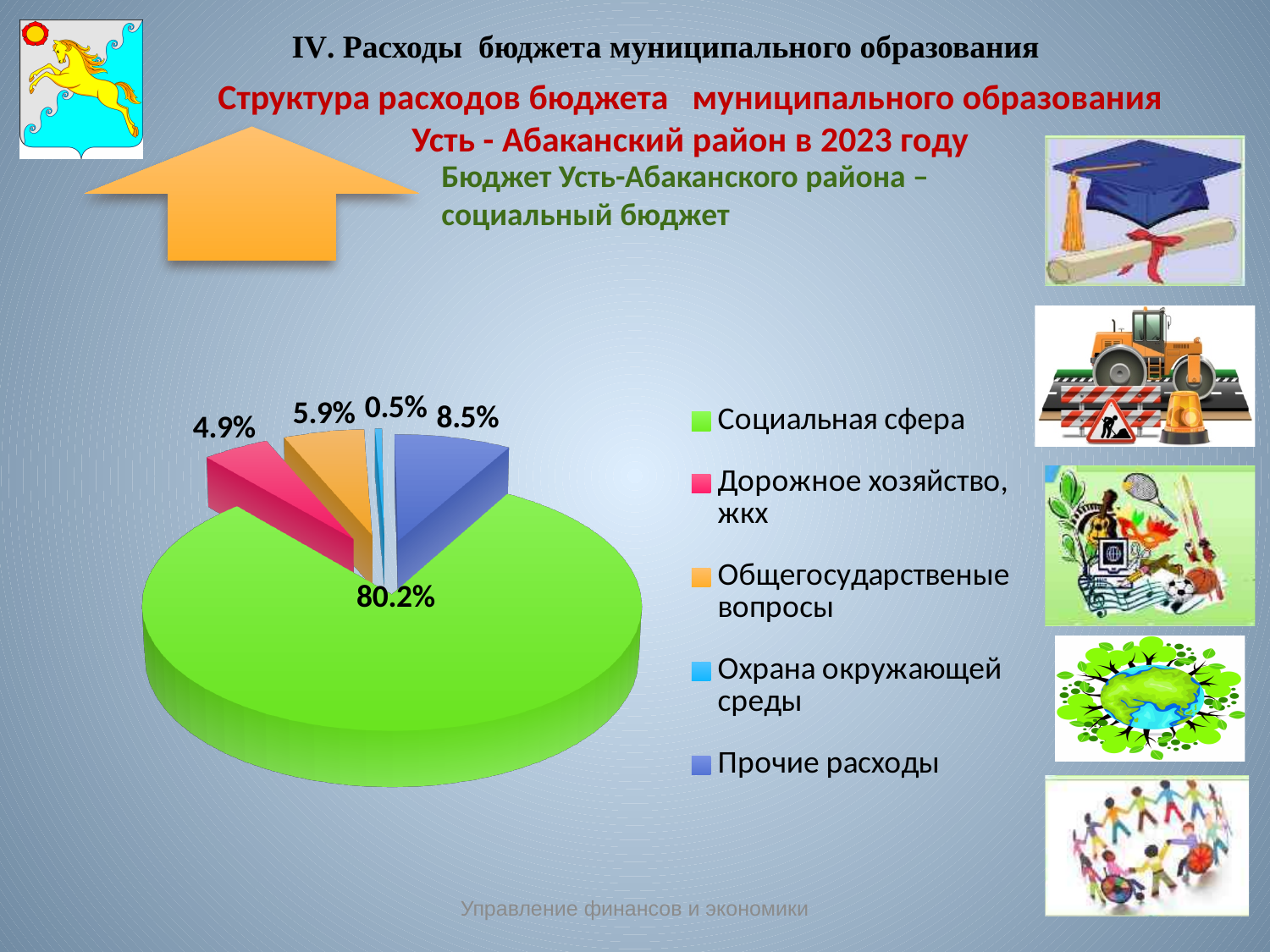
What share of the pie does Социальная сфера have? 80.2% What is the difference between the shares of Прочие расходы and Дорожное хозяйство, жкх? 3.6% What kind of chart is shown on the slide? pie chart What is the value for Дорожное хозяйство, жкх? 4.9% What is the value for Общегосударственые вопросы? 5.9% Which is larger, Прочие расходы or Общегосударственые вопросы? Прочие расходы Which category has the largest share of the pie? Социальная сфера What colour is the slice for Социальная сфера? green How many categories does the legend list? 5 What is the value for Прочие расходы? 8.5% What is the value for Охрана окружающей среды? 0.5% Which category has the smallest share of the pie? Охрана окружающей среды